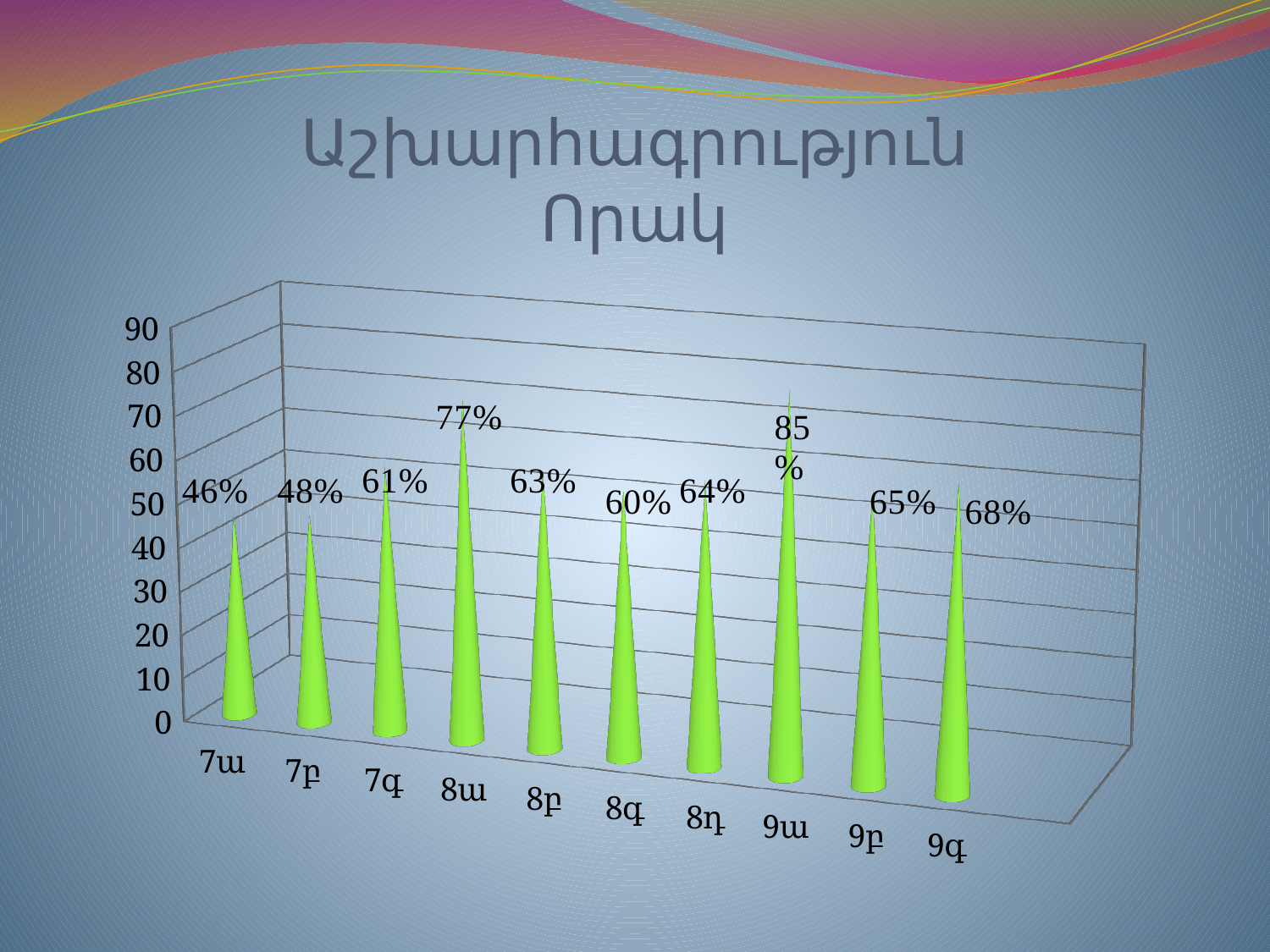
Which category has the lowest value? 7ա What is the title of the chart? Աշխարհագրություն Որակ Is the value for 7բ greater or less than 50? less What is the value for 7ա? 46% What kind of chart is shown on the slide? bar chart What is the difference between the values for 9ա and 7ա? 39% What is the value for 9բ? 65% Which category has the highest value? 9ա How many categories are shown on the x axis? 10 What is the value for 8ա? 77% Which is larger, the value for 8գ or the value for 9գ? 9գ What is the difference between the values for 8ա and 8բ? 14%